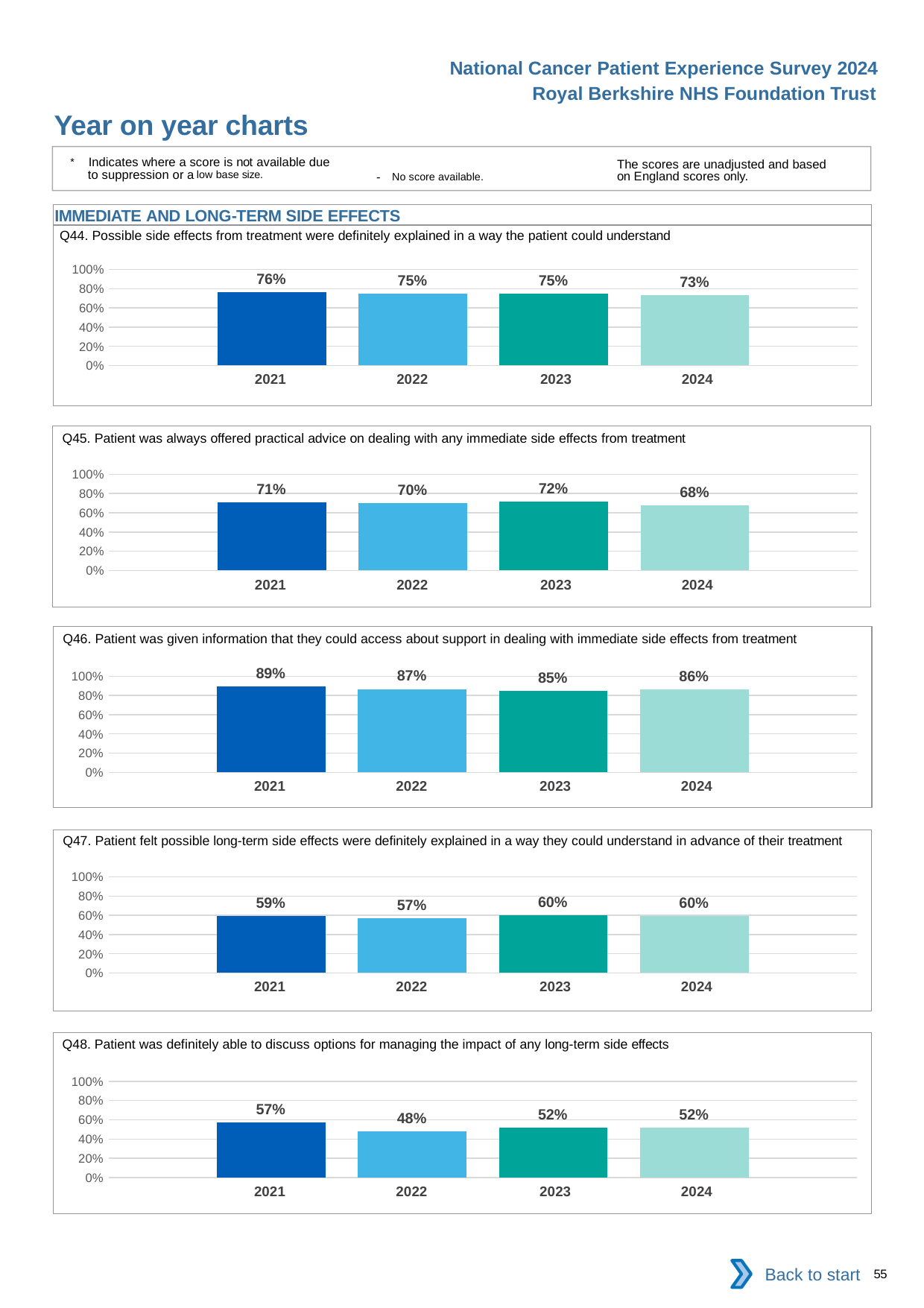
In the Q48 chart, is the value for 2022 greater or less than 60%? less In the Q45 chart, which year has the lowest value? 2024 In the Q47 chart, what is the value for 2024? 60% How many years are shown in the Q44 chart? 4 In the Q46 chart, what is the value for 2023? 85% In the Q46 chart, which year has the highest value? 2021 How many charts are shown on the slide? 5 What kind of chart is the Q45 chart? bar chart In the Q47 chart, which is larger, the value for 2021 or the value for 2022? 2021 In the Q44 chart, what is the value for 2021? 76% In the Q44 chart, do the values rise or fall from 2021 to 2024? fall In the Q48 chart, what is the difference between the 2021 and 2022 values? 9%